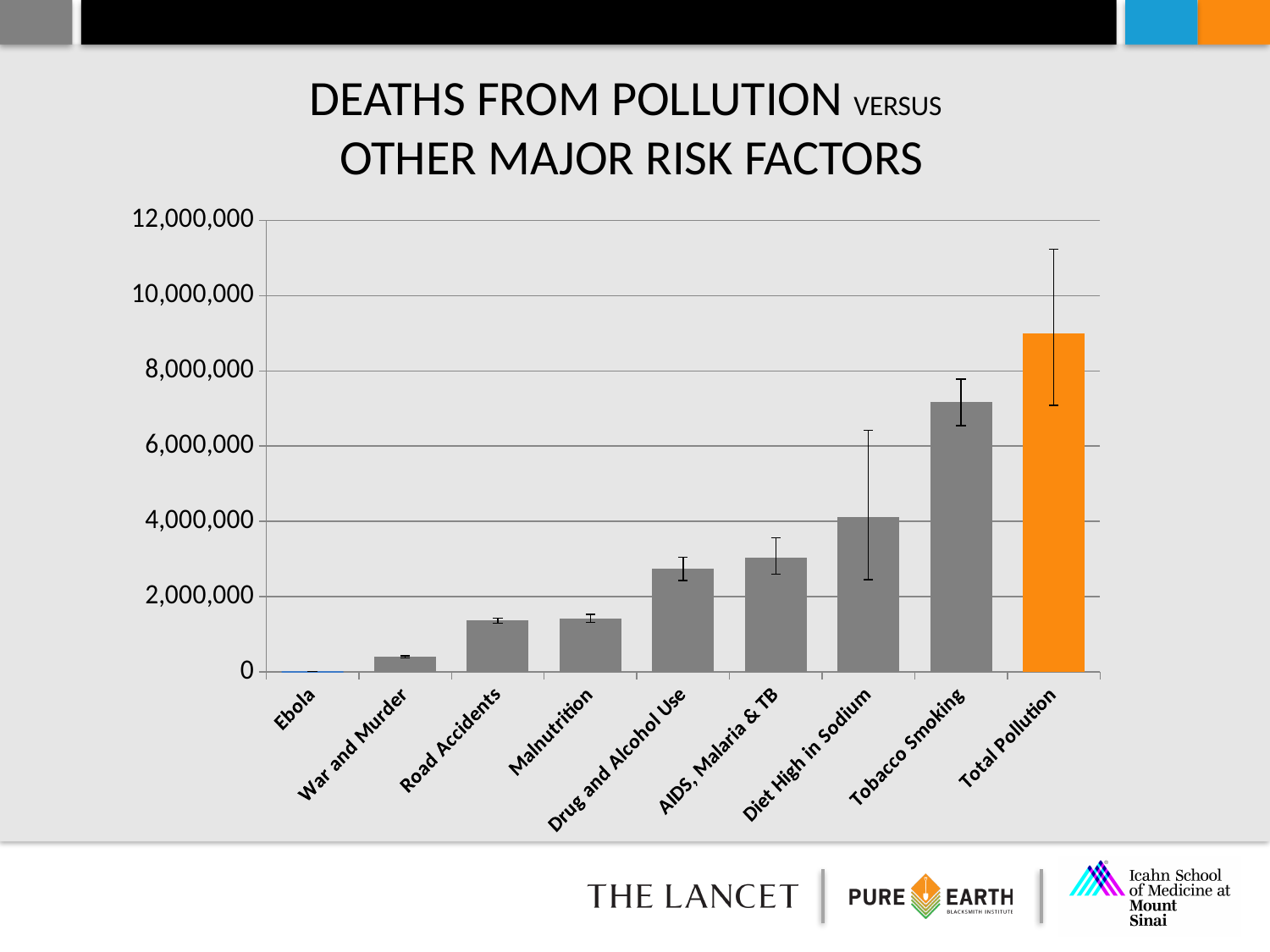
Which category has the lowest value in the chart? Ebola What kind of chart is shown on the slide? bar chart Do the bar values generally rise or fall from left to right along the x axis? rise Is the value for AIDS, Malaria & TB greater or less than 2,000,000? greater Is the value for Malnutrition greater or less than 2,000,000? less Which is larger, the value for Tobacco Smoking or the value for Diet High in Sodium? Tobacco Smoking Which category's bar is coloured orange rather than grey? Total Pollution Is the value for Tobacco Smoking greater or less than 6,000,000? greater How many categories are shown on the x axis of the chart? 9 Which category has the highest value in the chart? Total Pollution